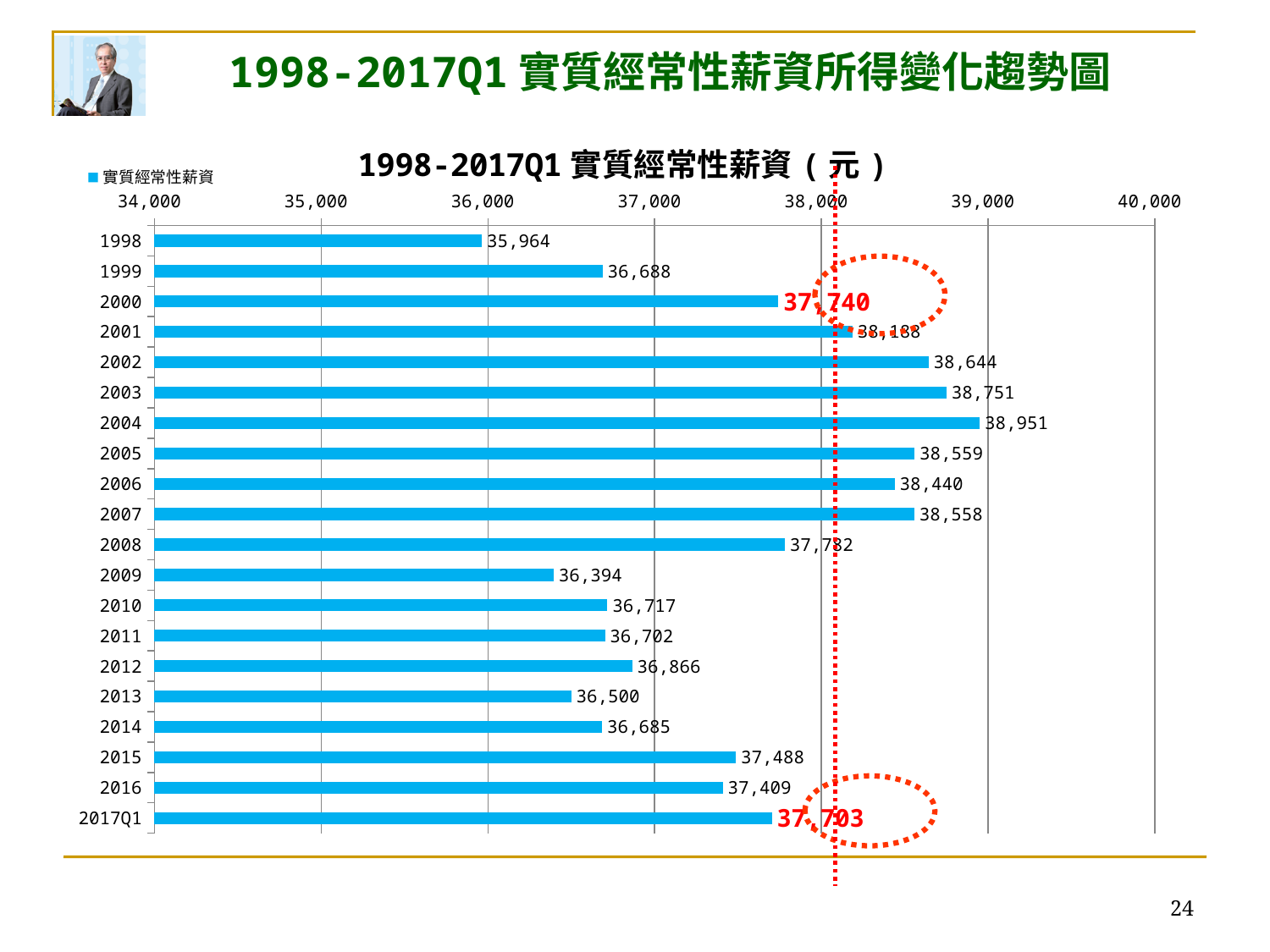
How many categories (years/periods) are shown on the chart? 20 How many series does the legend list? 1 Which year has the lowest value? 1998 Is the value for 2008 greater or less than 38,000? less What is the value for 2017Q1? 37,703 What is the value for 2004? 38,951 What is the value for 2009? 36,394 Which year has the highest value? 2004 What is the difference between the values for 2000 and 2017Q1? 37 What kind of chart is shown on the slide? bar chart Which is larger, the value for 2015 or the value for 2016? 2015 What is the value for 1998? 35,964